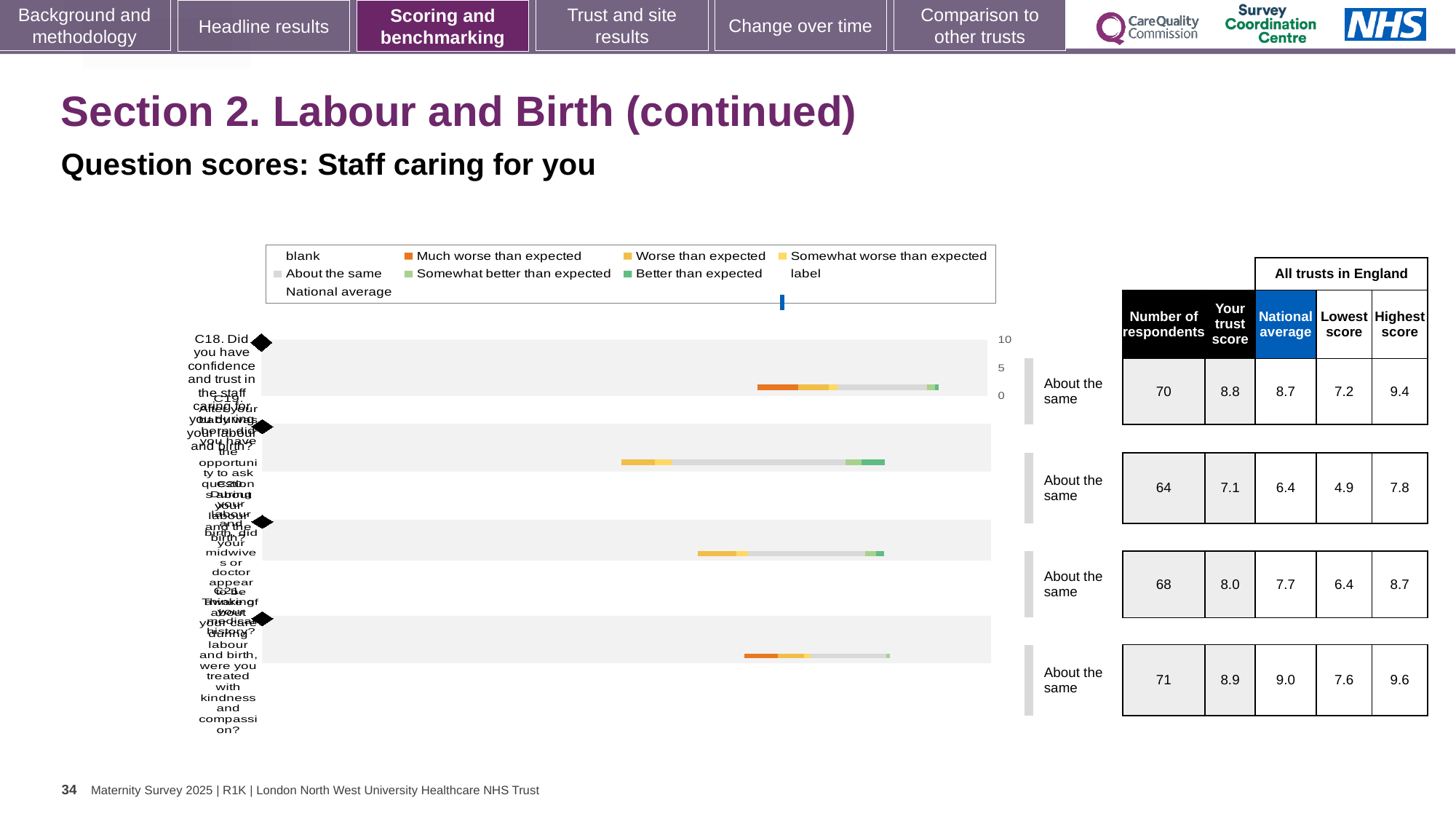
What is the national average for the second row of the chart? 6.4 What colour does the legend use for 'Much worse than expected'? Orange What is the number of respondents for the first row (C18, confidence and trust in staff)? 70 Which row has the highest 'Your trust score'? The fourth row (8.9) How many question rows are plotted in the chart? 4 In the second row, which is larger: the trust score or the national average? The trust score (7.1) What kind of chart is shown on the slide? Bar chart What benchmark category is shown for all four rows of the chart? About the same What is the number of respondents for the third row of the chart? 68 For the first row, what is the difference between the highest score (9.4) and the lowest score (7.2)? 2.2 What is the trust score for the first row (C18, confidence and trust in staff)? 8.8 What is the lowest 'Lowest score' value shown across the four rows? 4.9